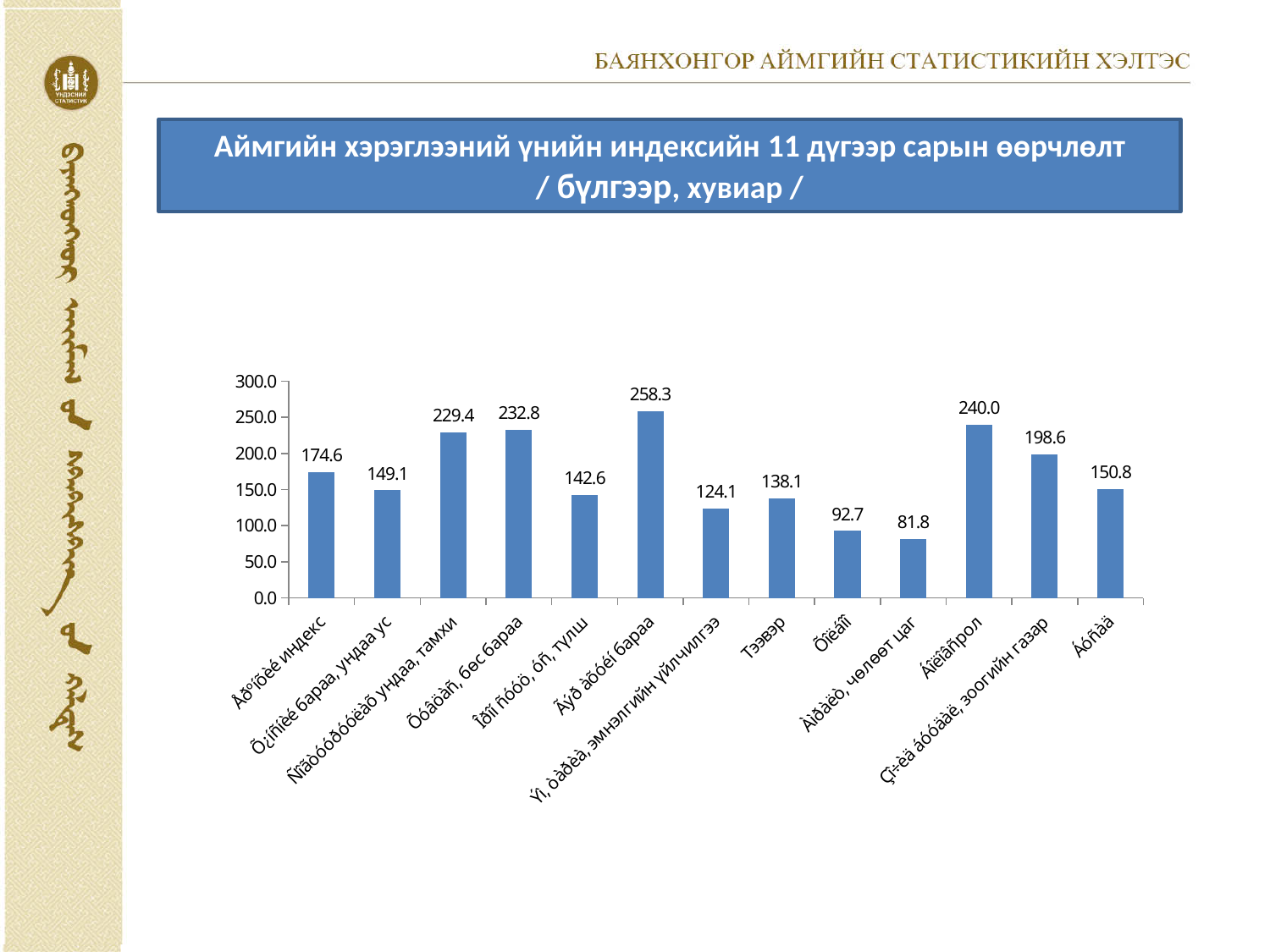
What is the value of the first (leftmost) bar in the chart? 174.6 How many bars are plotted in the chart? 13 What is the maximum value shown on the vertical axis of the chart? 300.0 What is the value of the last (rightmost) bar in the chart? 150.8 What is the value of the sixth bar from the left? 258.3 What is the lowest value shown in the chart? 81.8 What kind of chart is shown on the slide? bar chart What is the value for Тээвэр? 138.1 What is the difference between the highest value (258.3) and the lowest value (81.8) in the chart? 176.5 Which is larger: the value for Тээвэр or the value of the first bar (174.6)? the first bar (174.6) What is the highest value shown in the chart? 258.3 Is the value for Тээвэр greater or less than 150.0? less